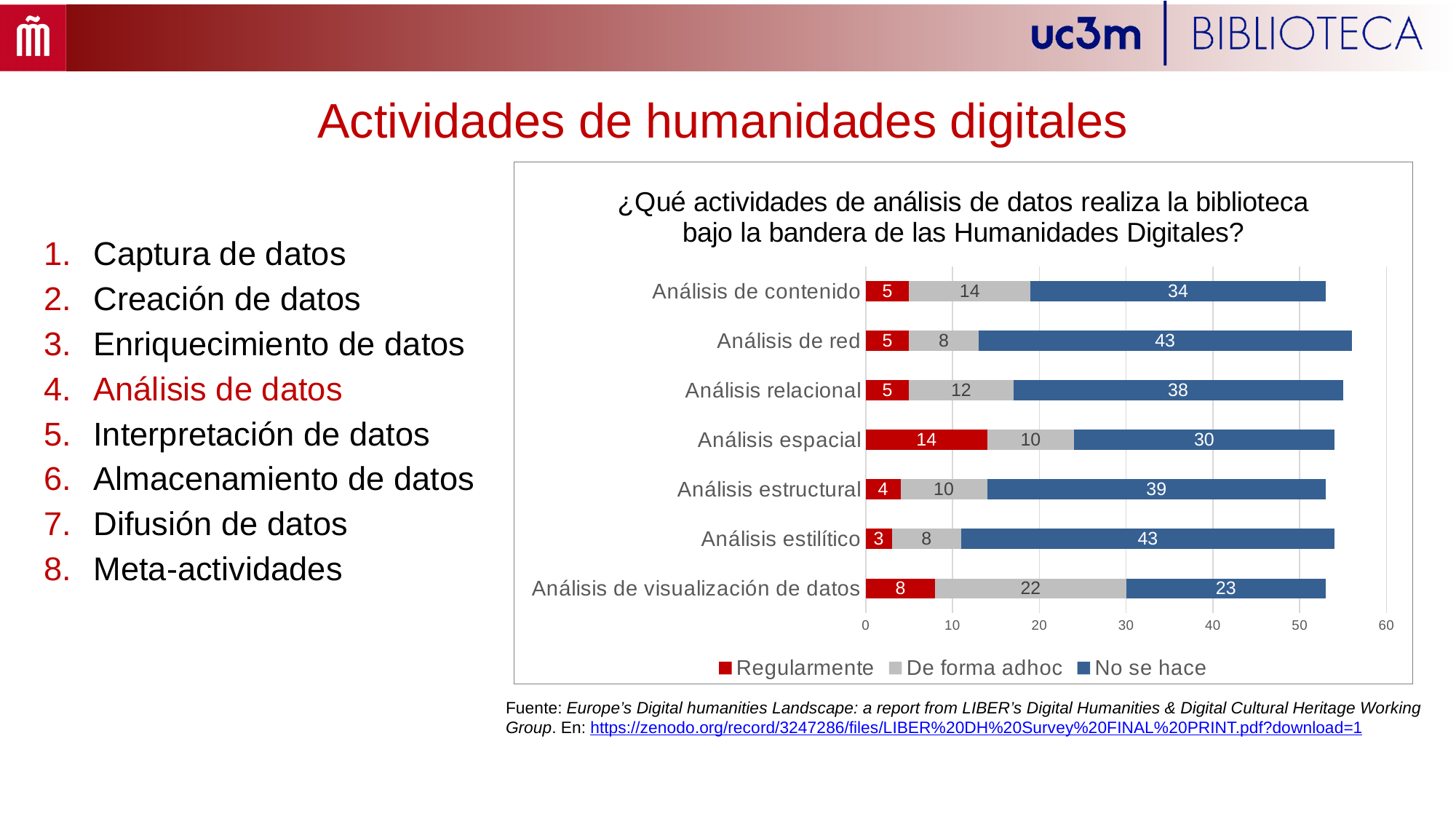
What is the 'De forma adhoc' value for Análisis de visualización de datos? 22 Which series is shown in red in the legend? Regularmente Which category has the lowest 'Regularmente' value? Análisis estilítico How many series does the legend list? 3 What is the 'No se hace' value for Análisis de contenido? 34 How many categories are plotted in the chart? 7 What is the difference between the 'No se hace' values for Análisis de red and Análisis espacial? 13 What is the total of the stacked bar for Análisis de red? 56 Which is larger: the 'De forma adhoc' value for Análisis de contenido or for Análisis relacional? Análisis de contenido What is the 'Regularmente' value for Análisis espacial? 14 Which category has the highest 'Regularmente' value? Análisis espacial What kind of chart is shown on the slide? Stacked bar chart